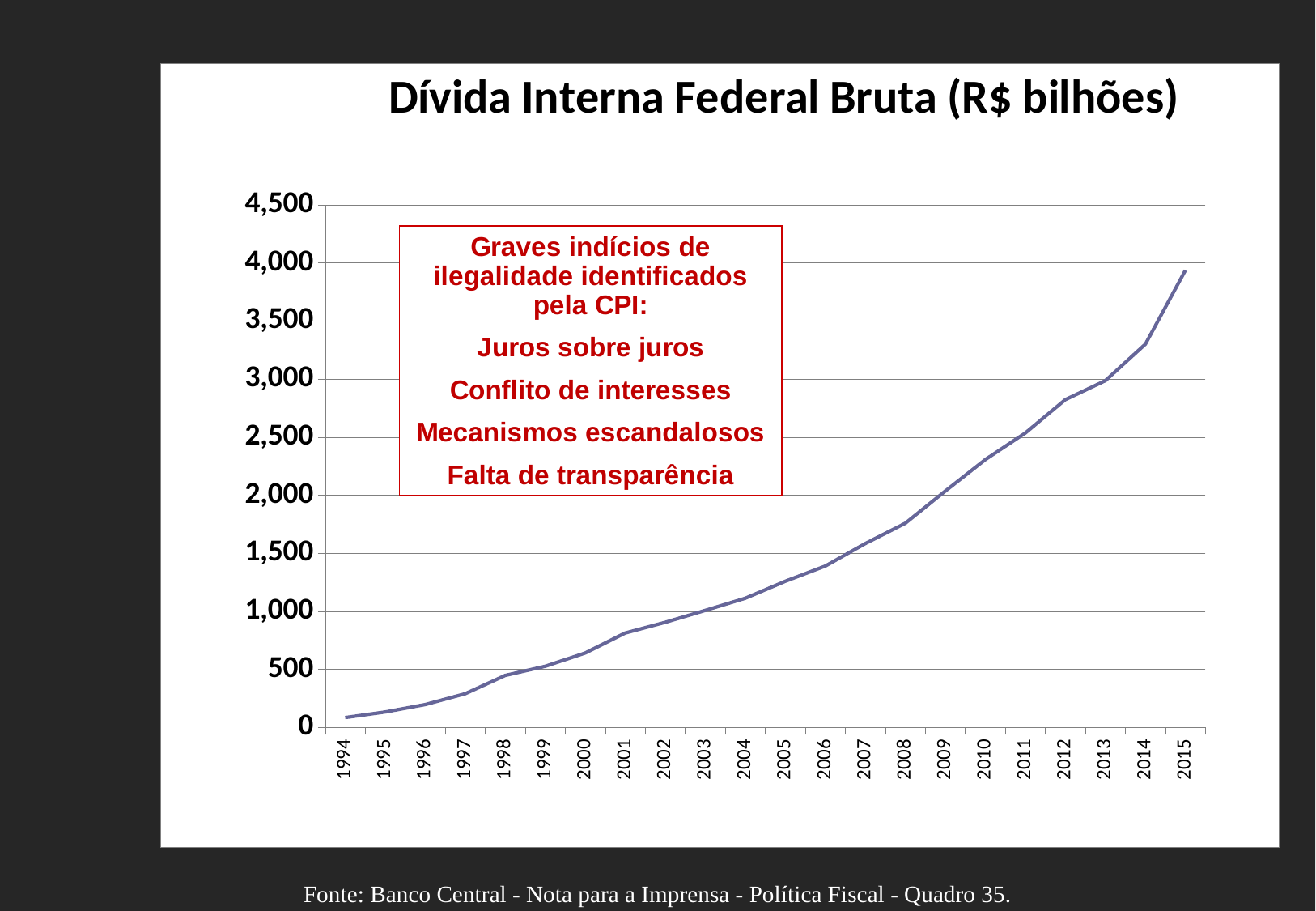
Which is larger, the value for 2010 or the value for 2005? 2010 Is the value for 2006 greater or less than 1,500? less Is the value for 2015 greater or less than 3,500? greater What is the title of the chart? Dívida Interna Federal Bruta (R$ bilhões) Which year has the highest value? 2015 Is the value for 2008 greater or less than 1,500? greater What kind of chart is shown on the slide? line chart Which year has the lowest value? 1994 Do the values rise or fall from 1994 to 2015? rise How many years are plotted along the x axis? 22